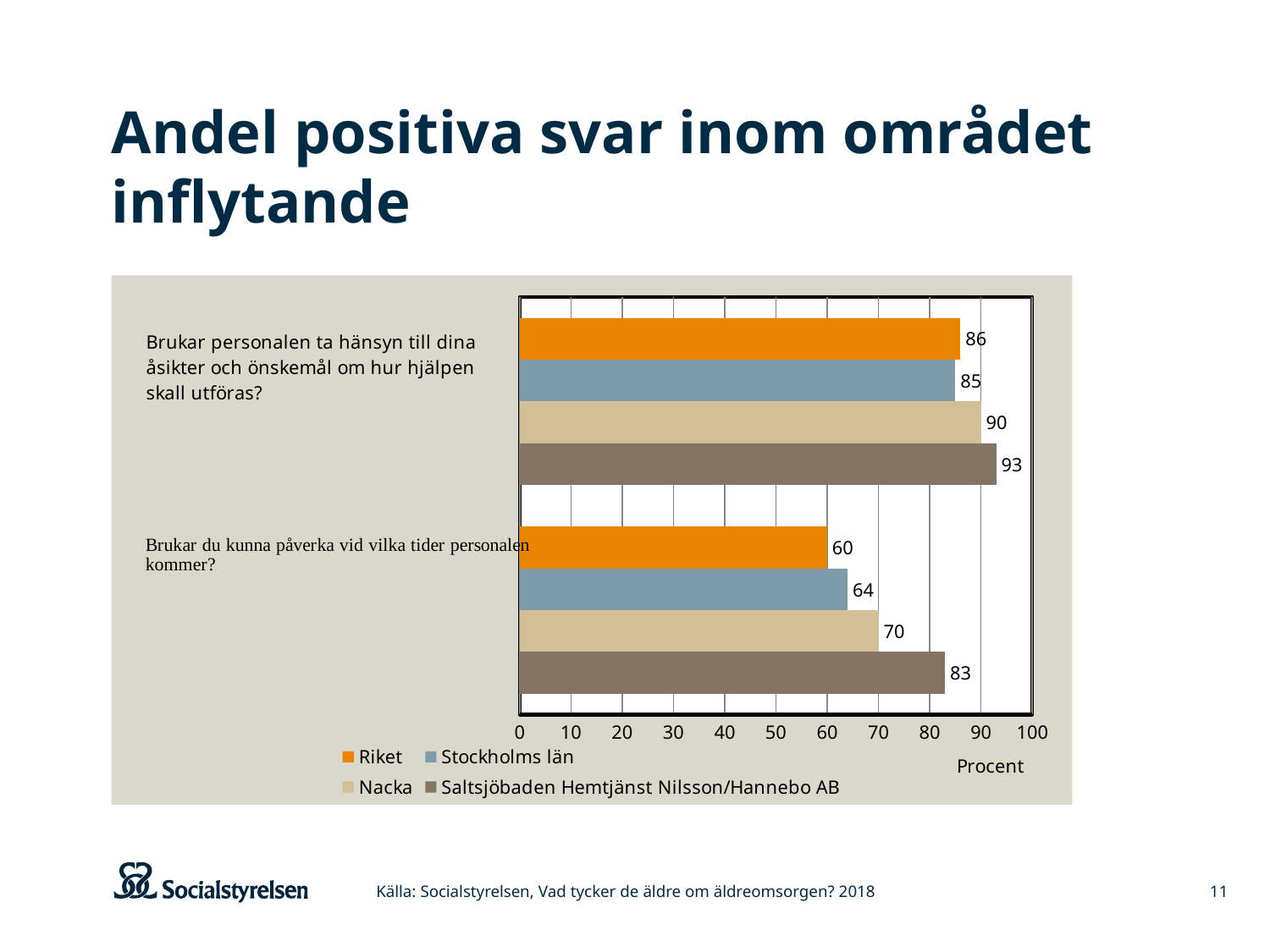
What is the value for Saltsjöbaden Hemtjänst Nilsson/Hannebo AB for the question 'Brukar du kunna påverka vid vilka tider personalen kommer?'? 83 What is the value for Stockholms län for the question 'Brukar personalen ta hänsyn till dina åsikter och önskemål om hur hjälpen skall utföras?'? 85 What is the value for Riket for the question 'Brukar personalen ta hänsyn till dina åsikter och önskemål om hur hjälpen skall utföras?'? 86 What kind of chart is shown on the slide? bar chart What is the value for Nacka for the question 'Brukar du kunna påverka vid vilka tider personalen kommer?'? 70 Which series has the highest value for the question 'Brukar du kunna påverka vid vilka tider personalen kommer?'? Saltsjöbaden Hemtjänst Nilsson/Hannebo AB What is the difference between the Saltsjöbaden Hemtjänst Nilsson/Hannebo AB value and the Riket value for the question 'Brukar personalen ta hänsyn till dina åsikter och önskemål om hur hjälpen skall utföras?'? 7 How many questions (categories) are shown on the chart? 2 Which series has the lowest value for the question 'Brukar du kunna påverka vid vilka tider personalen kommer?'? Riket How many series does the legend list? 4 Which is larger for the question 'Brukar du kunna påverka vid vilka tider personalen kommer?': the value for Stockholms län or the value for Nacka? Nacka What label is shown on the horizontal axis of the chart? Procent